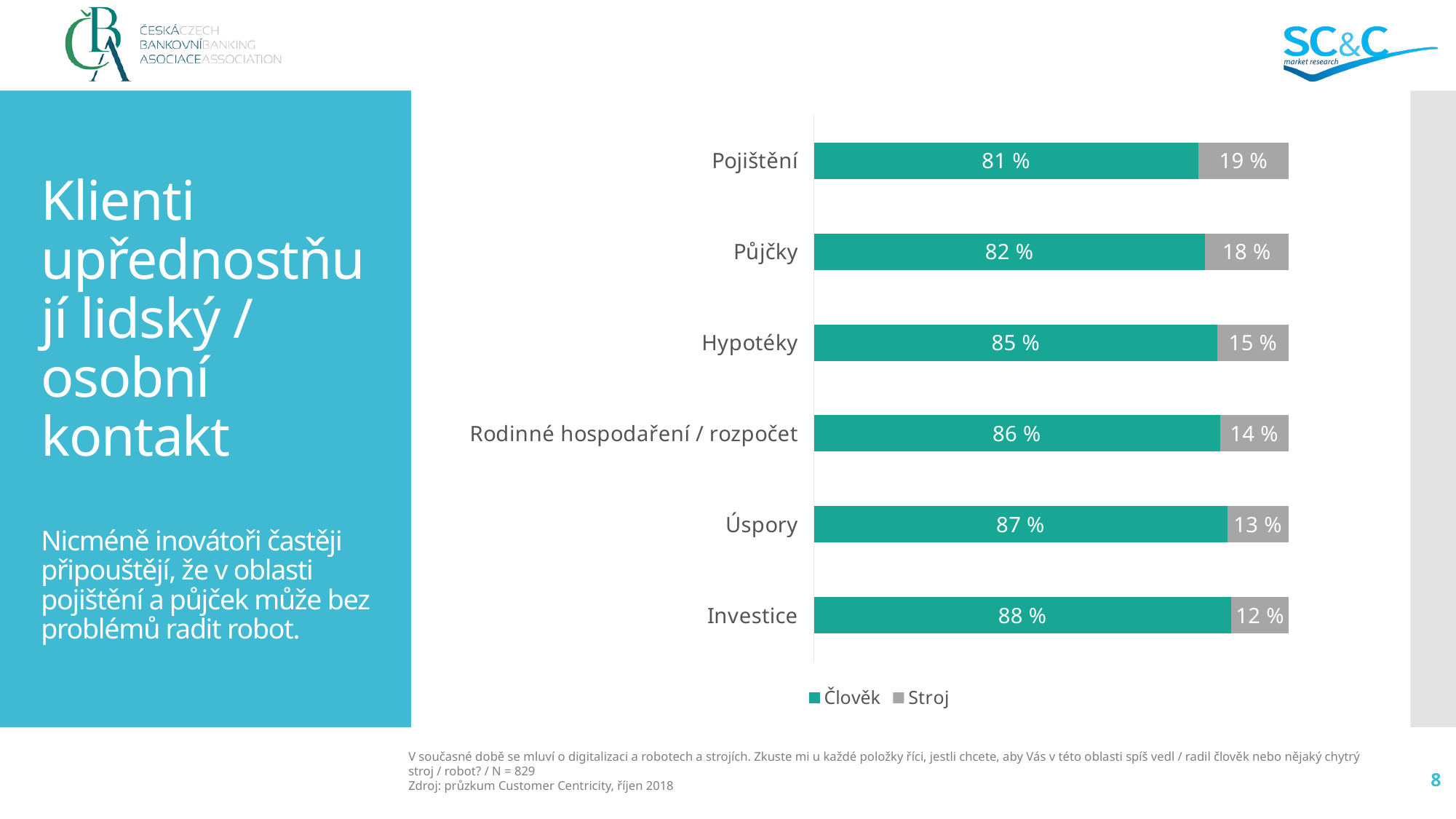
How many categories are shown in the chart? 6 What is the value for Stroj for Hypotéky? 15 % How many series does the legend list? 2 Which is larger, the Stroj value for Půjčky or the Stroj value for Úspory? Půjčky Which category has the highest value for Stroj? Pojištění Which category has the highest value for Člověk? Investice What is the value for Člověk for Rodinné hospodaření / rozpočet? 86 % What is the difference between the Člověk values for Investice and Pojištění? 7 % Which category has the lowest value for Člověk? Pojištění What kind of chart is shown on the slide? Stacked bar chart What is the value for Stroj for Investice? 12 % What is the value for Člověk for Pojištění? 81 %